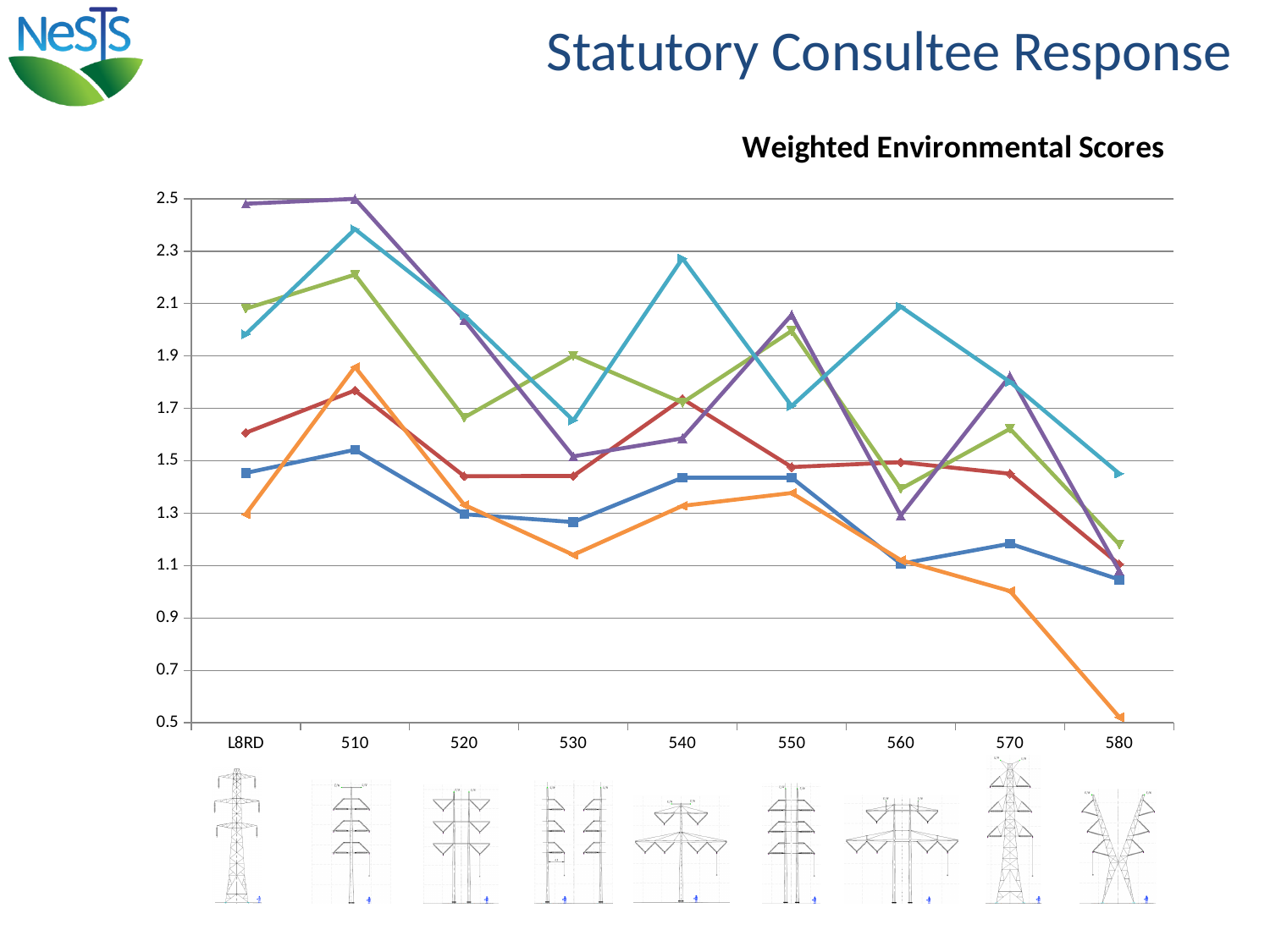
Is the value of the blue line at 570 greater or less than 1.3? less Does the orange line rise or fall from 550 to 580? fall Is the value of the red line at 510 greater or less than 1.5? greater What kind of chart is shown on the slide? line chart Is the value of the orange line at 580 greater or less than 0.7? less What is the label of the first category on the x axis? L8RD How many categories are shown along the x axis of the chart? 9 What is the title of the chart? Weighted Environmental Scores Does the purple line rise or fall from 510 to 530? fall